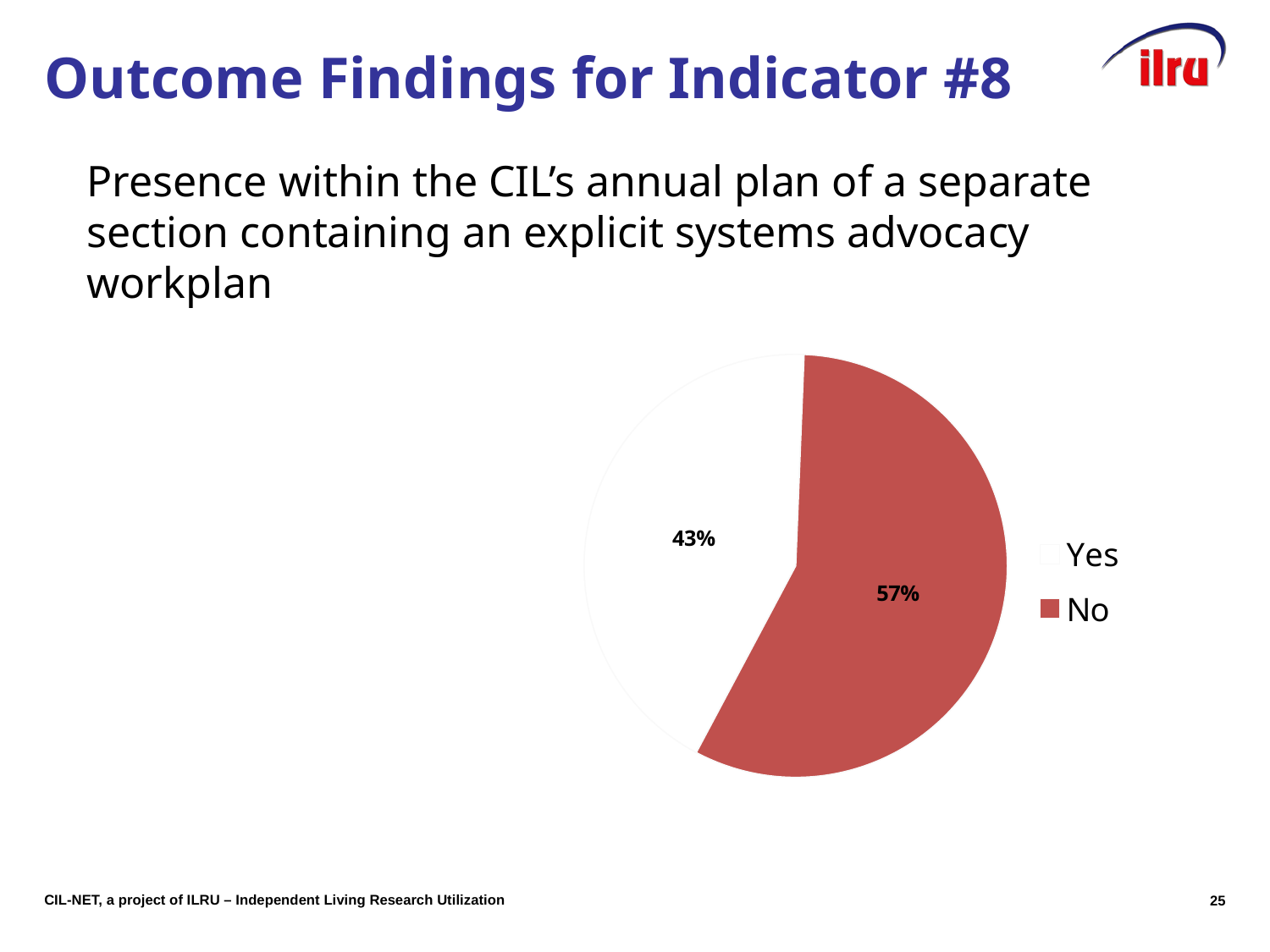
What is the difference in percentage points between the "No" slice and the "Yes" slice? 14 Which slice of the pie is the largest? No How many slices does the pie chart have? 2 Which is larger, the "Yes" slice or the "No" slice? No What share of the pie does the "No" slice represent? 57% How many entries does the legend list? 2 What colour is the "No" slice in the pie chart? red What are the two legend entries of the pie chart? Yes and No What percentage of the pie is labelled "Yes"? 43% What kind of chart is shown on the slide? pie chart What percentage of the pie is labelled "No"? 57% Which slice of the pie is the smallest? Yes